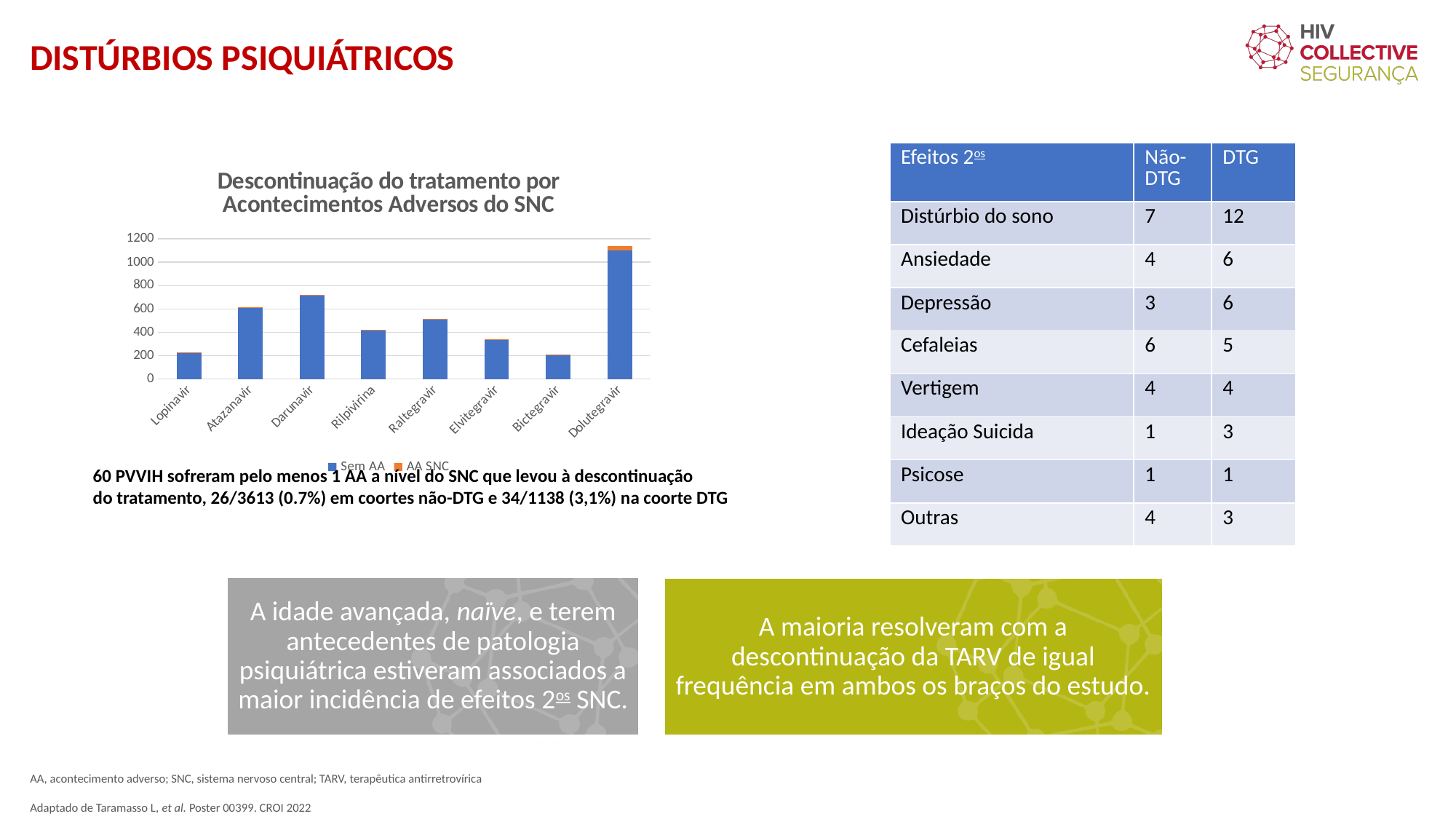
Is the total bar for Lopinavir greater or less than 400? less Is the total bar for Elvitegravir greater or less than 400? less What is the title of the chart? Descontinuação do tratamento por Acontecimentos Adversos do SNC Which series in the chart legend is shown in orange? AA SNC Is the total bar for Rilpivirina greater or less than 600? less How many series does the chart legend list? 2 How many drug categories are shown on the x axis of the chart? 8 Which drug has the highest bar in the chart? Dolutegravir What kind of chart is shown on the slide? bar chart Which bar is taller, Darunavir or Atazanavir? Darunavir